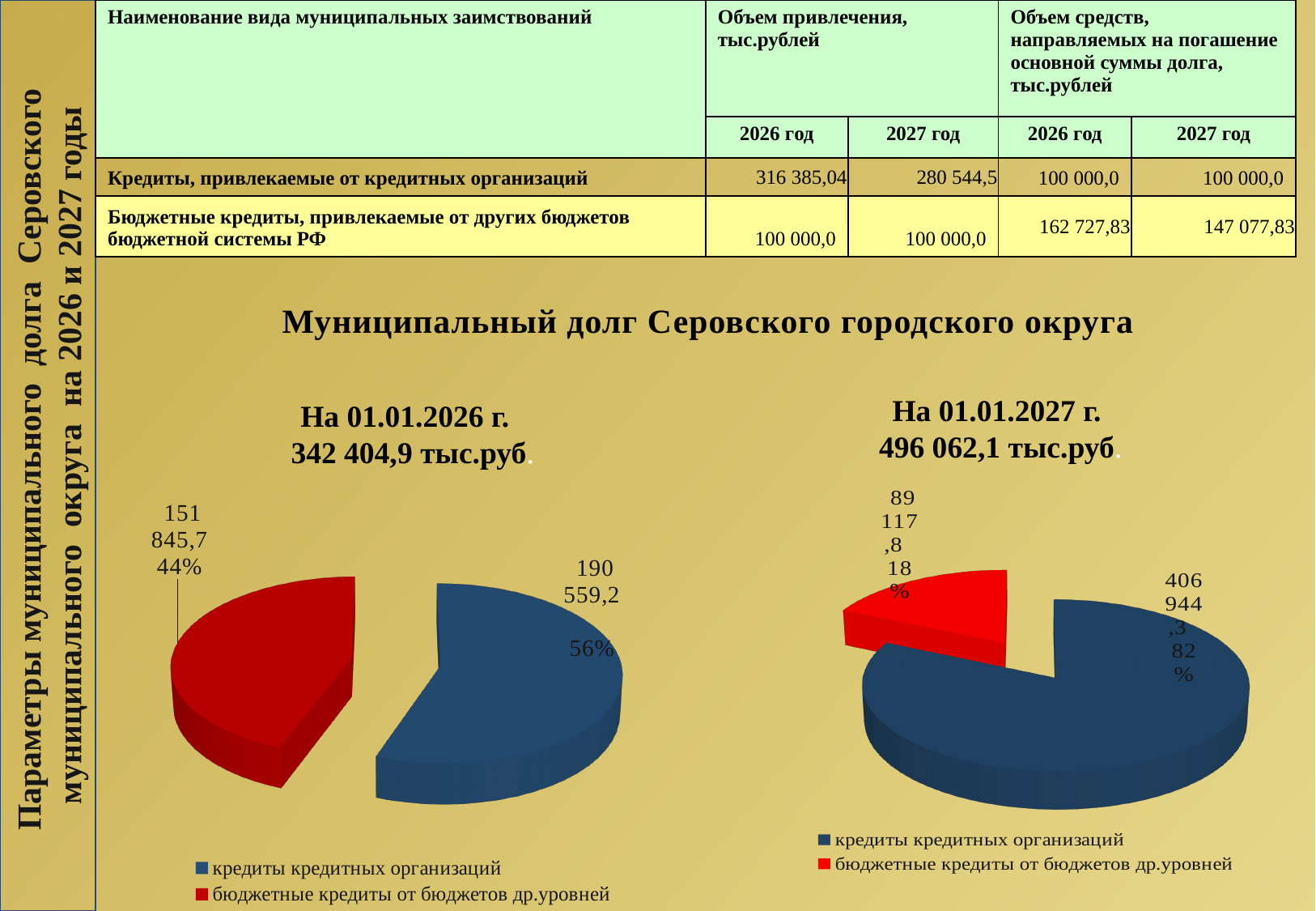
In the 'На 01.01.2026 г.' pie chart, which is larger: кредиты кредитных организаций or бюджетные кредиты от бюджетов др.уровней? кредиты кредитных организаций What is the overall title above the two pie charts? Муниципальный долг Серовского городского округа What kind of chart is used for the 'На 01.01.2026 г.' data? pie chart In the 'На 01.01.2027 г.' pie chart, which slice is the largest? кредиты кредитных организаций In the 'На 01.01.2027 г.' pie chart, what is the value for кредиты кредитных организаций? 406 944,3 In the 'На 01.01.2026 г.' pie chart, what is the value for кредиты кредитных организаций? 190 559,2 In the 'На 01.01.2026 г.' pie chart, which slice is the smallest? бюджетные кредиты от бюджетов др.уровней In the 'На 01.01.2026 г.' pie chart, what is the value for бюджетные кредиты от бюджетов др.уровней? 151 845,7 In the 'На 01.01.2026 г.' pie chart, what share does кредиты кредитных организаций have? 56% In the 'На 01.01.2027 г.' pie chart, what share does бюджетные кредиты от бюджетов др.уровней have? 18% In the 'На 01.01.2027 г.' pie chart, what is the value for бюджетные кредиты от бюджетов др.уровней? 89 117,8 How many slices does the 'На 01.01.2027 г.' pie chart have? 2